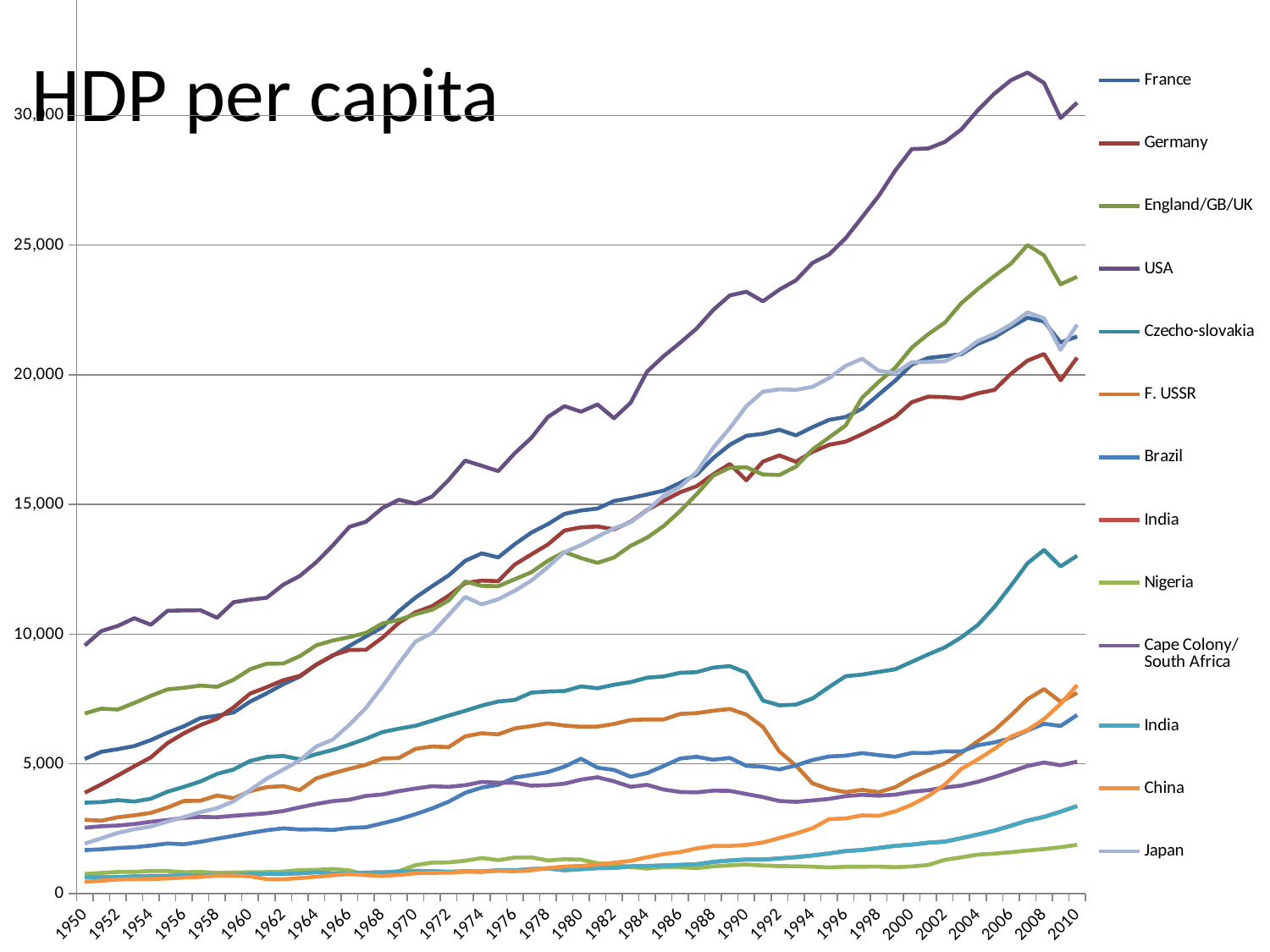
Is the value for Nigeria in 2010 greater or less than 5,000? less Is the value for Czecho-slovakia in 2010 greater or less than 10,000? greater Is the value for England/GB/UK in 2010 greater or less than 25,000? less Which series has the lowest value in 2010? Nigeria How many series does the legend list? 13 What is the title of the chart? HDP per capita In 2010, which is larger: the value for Czecho-slovakia or the value for Brazil? Czecho-slovakia Which series has the highest value in 2010? USA Does the USA series generally rise or fall from 1950 to 2010? rise What kind of chart is shown on the slide? line chart